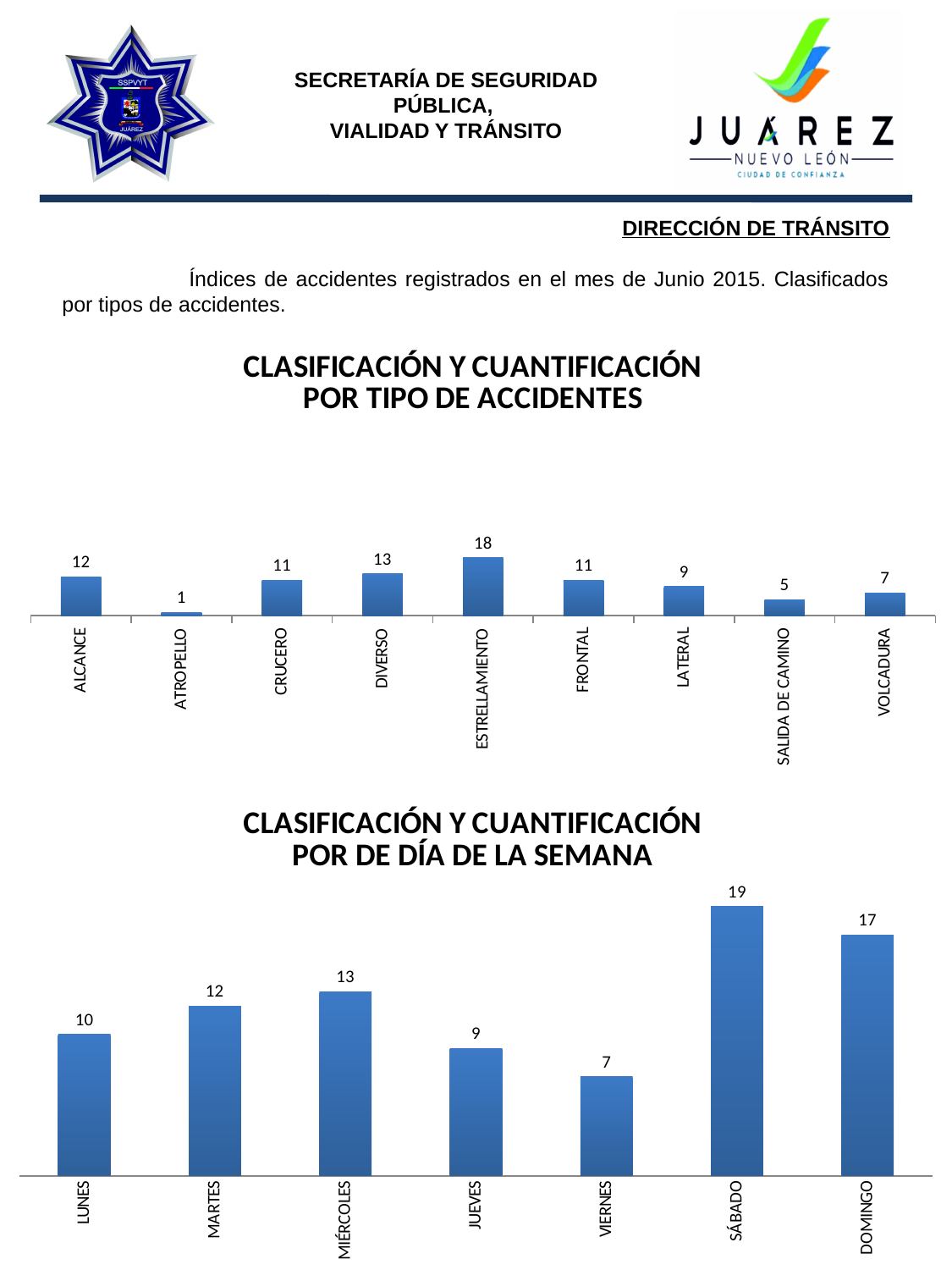
In the 'CLASIFICACIÓN Y CUANTIFICACIÓN POR DE DÍA DE LA SEMANA' chart, what is the difference between SÁBADO and DOMINGO? 2 In the 'CLASIFICACIÓN Y CUANTIFICACIÓN POR DE DÍA DE LA SEMANA' chart, which is larger, MARTES or JUEVES? MARTES In the 'CLASIFICACIÓN Y CUANTIFICACIÓN POR TIPO DE ACCIDENTES' chart, what is the value for VOLCADURA? 7 In the 'CLASIFICACIÓN Y CUANTIFICACIÓN POR TIPO DE ACCIDENTES' chart, what is the value for ESTRELLAMIENTO? 18 In the 'CLASIFICACIÓN Y CUANTIFICACIÓN POR TIPO DE ACCIDENTES' chart, how many accident types are shown? 9 In the 'CLASIFICACIÓN Y CUANTIFICACIÓN POR DE DÍA DE LA SEMANA' chart, how many days are shown? 7 In the 'CLASIFICACIÓN Y CUANTIFICACIÓN POR TIPO DE ACCIDENTES' chart, which accident type has the lowest value? ATROPELLO In the 'CLASIFICACIÓN Y CUANTIFICACIÓN POR TIPO DE ACCIDENTES' chart, which accident type has the highest value? ESTRELLAMIENTO What type of chart is the 'CLASIFICACIÓN Y CUANTIFICACIÓN POR DE DÍA DE LA SEMANA' chart? Bar chart In the 'CLASIFICACIÓN Y CUANTIFICACIÓN POR DE DÍA DE LA SEMANA' chart, which day has the highest value? SÁBADO In the 'CLASIFICACIÓN Y CUANTIFICACIÓN POR TIPO DE ACCIDENTES' chart, what is the difference between DIVERSO and SALIDA DE CAMINO? 8 In the 'CLASIFICACIÓN Y CUANTIFICACIÓN POR DE DÍA DE LA SEMANA' chart, what is the value for VIERNES? 7